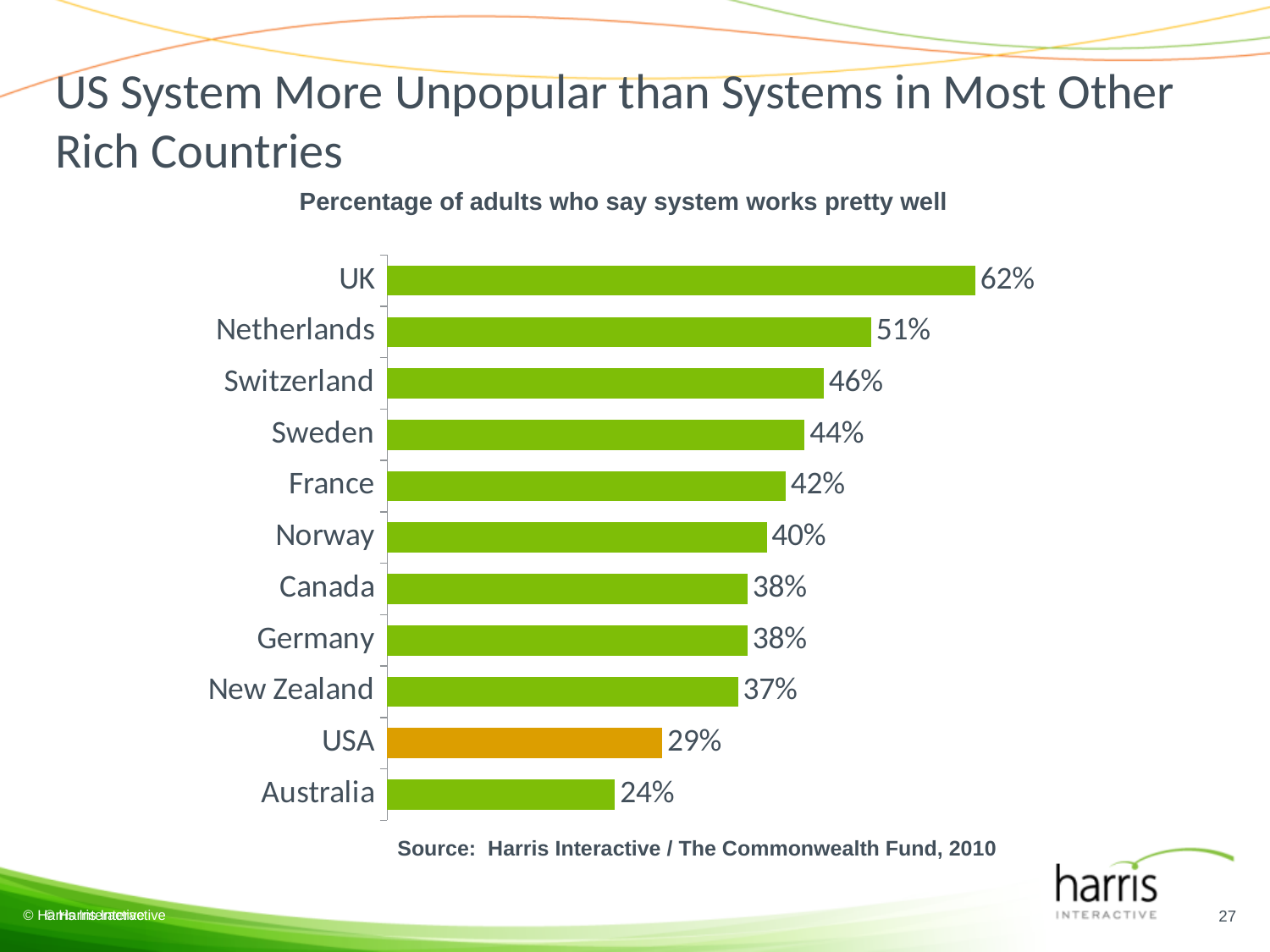
What kind of chart is shown on the slide? Bar chart How many countries are shown in the chart? 11 What percentage of adults in the UK say the system works pretty well? 62% What is the difference in percentage points between the UK and the USA? 33 What is the difference between the Netherlands and Switzerland values? 5 Which has a higher value, France or Norway? France What is the value shown for the USA? 29% What is the value shown for Sweden? 44% Which country's bar is coloured differently (orange) from the others? USA Which has a higher value, the USA or New Zealand? New Zealand Which country has the highest percentage of adults saying the system works pretty well? UK Which country has the lowest percentage? Australia